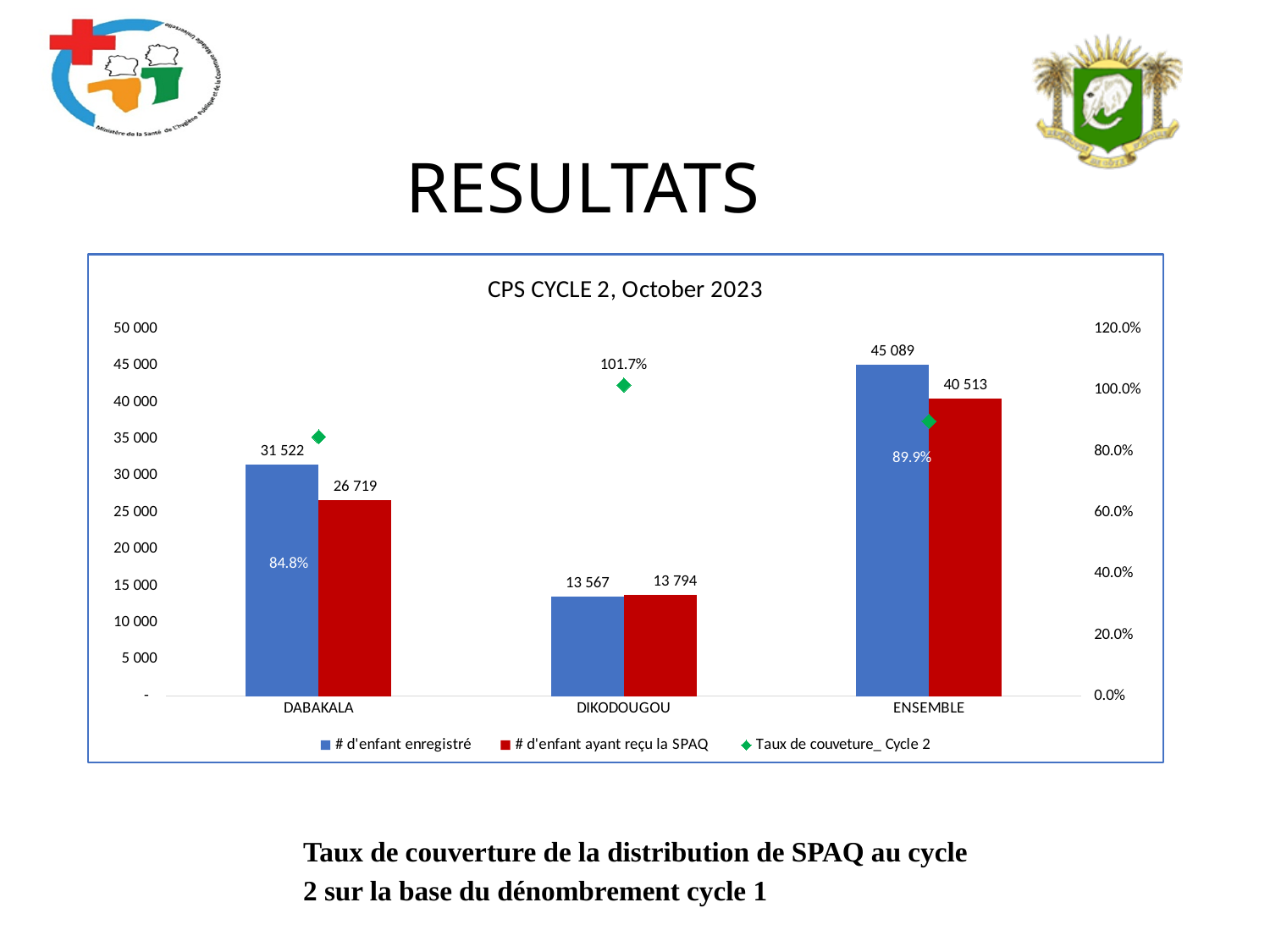
How many series does the legend list? 3 What is the value of # d'enfant enregistré for DABAKALA? 31 522 Which category has the highest value of # d'enfant enregistré? ENSEMBLE What is the difference between # d'enfant enregistré and # d'enfant ayant reçu la SPAQ for DABAKALA? 4 803 What is the title of the chart? CPS CYCLE 2, October 2023 Is the value of # d'enfant ayant reçu la SPAQ for DABAKALA greater or less than 25 000? greater How many categories are shown on the x axis? 3 What is the Taux de couveture_ Cycle 2 for DIKODOUGOU? 101.7% What is the value of # d'enfant ayant reçu la SPAQ for ENSEMBLE? 40 513 Which category has the lowest Taux de couveture_ Cycle 2? DABAKALA For DIKODOUGOU, which is larger: # d'enfant enregistré or # d'enfant ayant reçu la SPAQ? # d'enfant ayant reçu la SPAQ What is the Taux de couveture_ Cycle 2 for ENSEMBLE? 89.9%